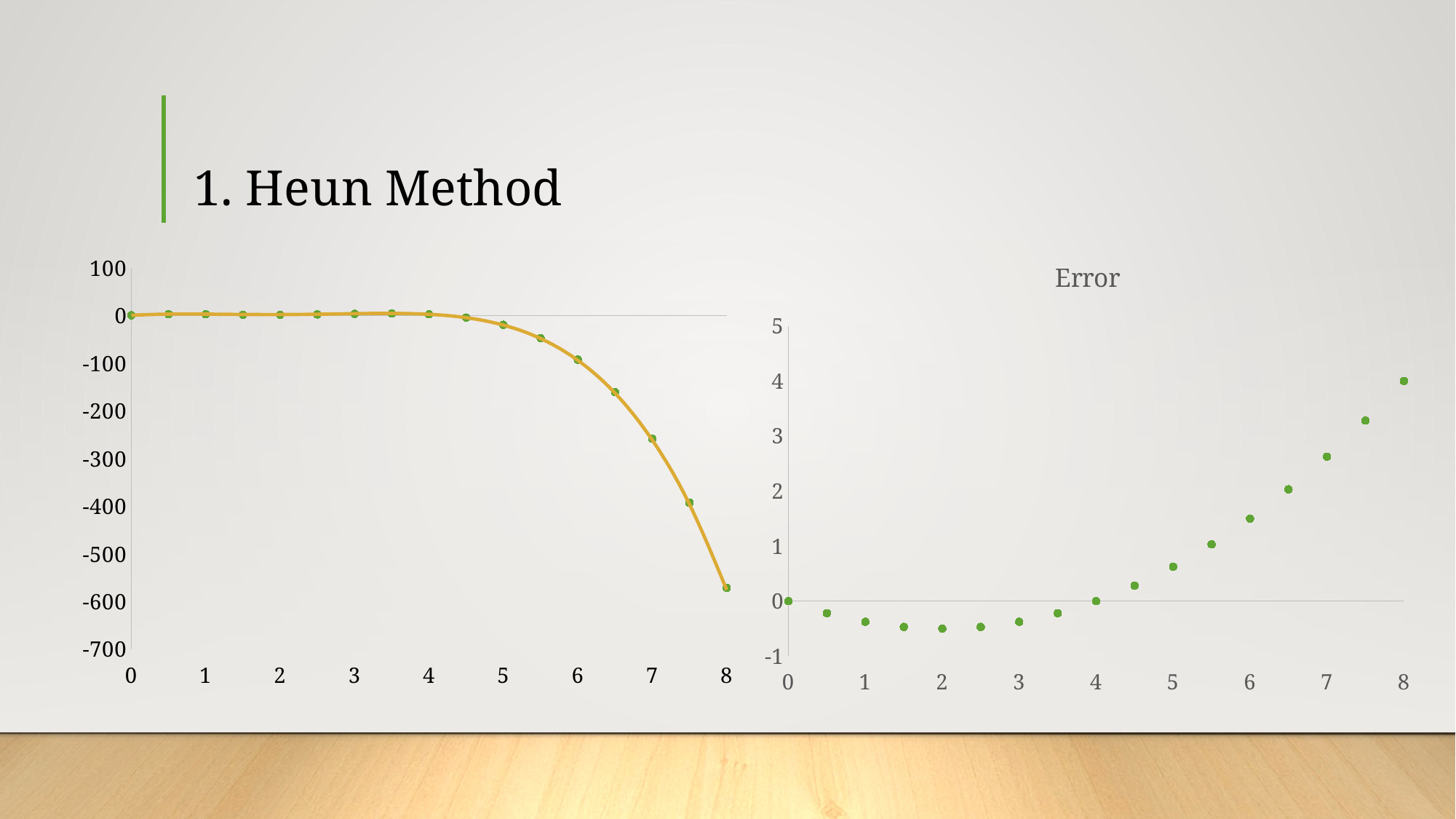
In the Error chart, do the values rise or fall between x = 4 and x = 8? rise What kind of chart is the chart on the left side of the slide? line chart In the left chart, is the value at x = 7 greater or less than -200? less In the left chart, is the value at x = 6 greater or less than -200? greater In the Error chart, is the value at x = 8 greater or less than 3? greater In the Error chart, at which x value is the error highest? 8 What is the title of the chart on the right side of the slide? Error What kind of chart is the Error chart? scatter chart In the left chart, at which x value is the plotted value lowest? 8